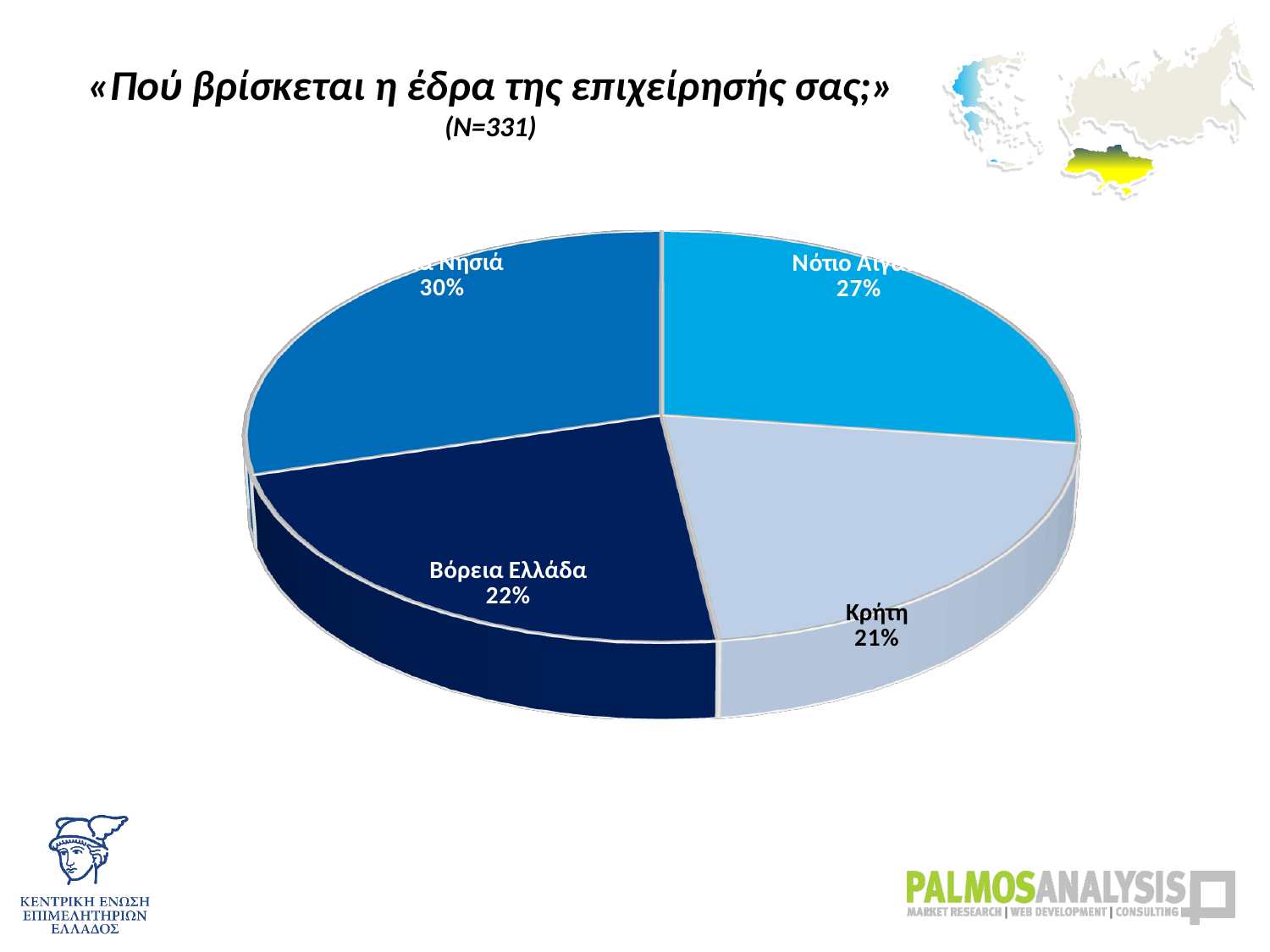
What is the difference in percentage points between the largest slice (30%) and Κρήτη? 9 percentage points What is the largest percentage shown on the pie chart? 30% What kind of chart is shown on the slide? Pie chart What is the combined share of Βόρεια Ελλάδα and Κρήτη? 43% What share of the pie does Κρήτη have? 21% How many slices does the pie chart have? 4 What sample size (N) is stated under the chart title? N=331 What is the difference in percentage points between Βόρεια Ελλάδα and Κρήτη? 1 percentage point Which slice of the pie is the smallest? Κρήτη What share of the pie does Βόρεια Ελλάδα have? 22% What is the title of the chart? «Πού βρίσκεται η έδρα της επιχείρησής σας;» Which has the larger share, Βόρεια Ελλάδα or Κρήτη? Βόρεια Ελλάδα